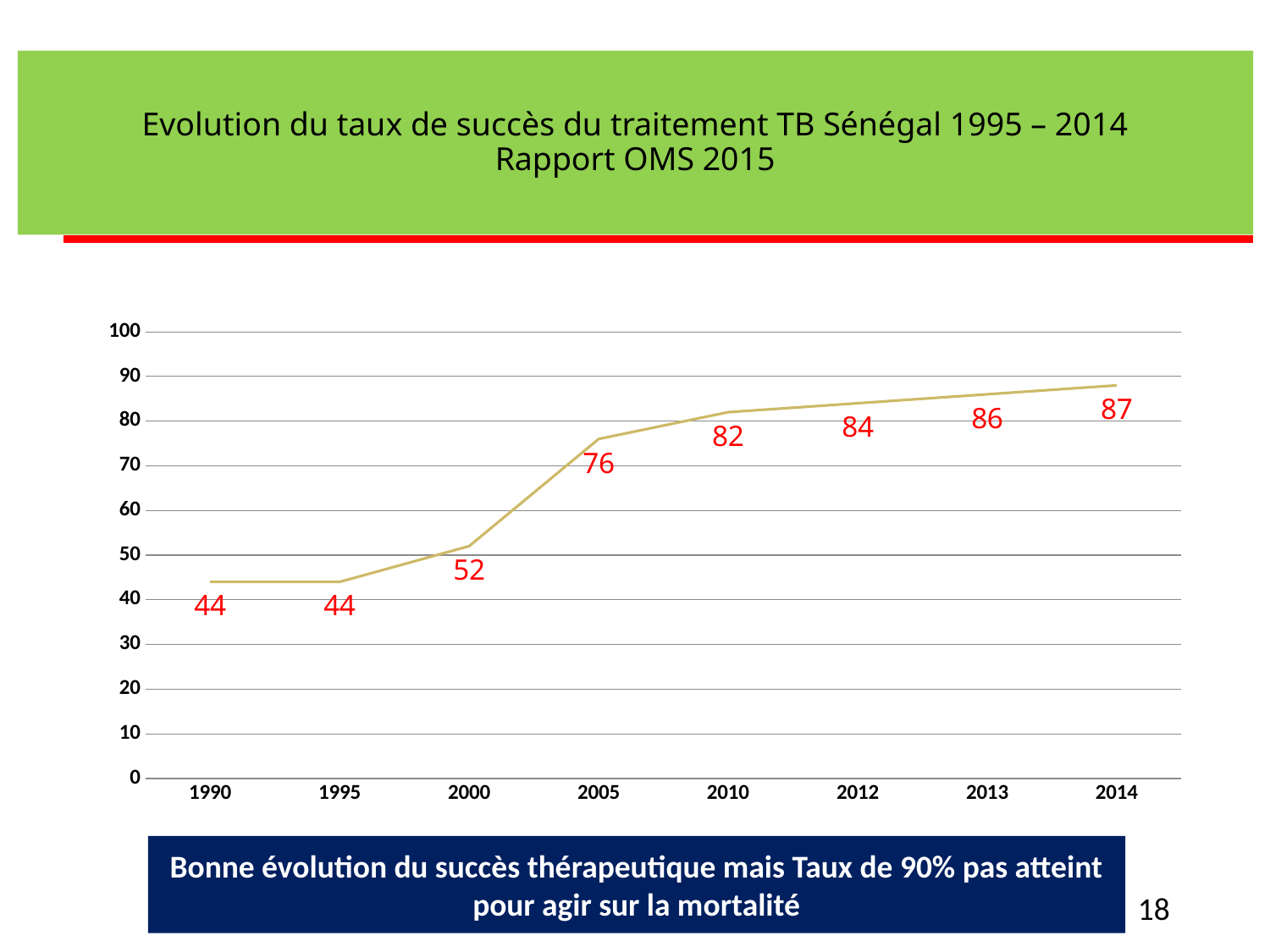
What is the value for 2005? 76 What is the value for 2000? 52 What is the difference between the values for 2014 and 1990? 43 How many years are plotted on the x axis? 8 Which is larger, the value for 2010 or the value for 2005? 2010 What kind of chart is shown? line chart What is the value for 2014? 87 Is the value for 2012 greater or less than 80? greater Which year has the highest value? 2014 What is the title of the slide? Evolution du taux de succès du traitement TB Sénégal 1995 – 2014 Rapport OMS 2015 Do the values rise or fall from 1990 to 2014? rise What is the difference between the values for 2005 and 2000? 24